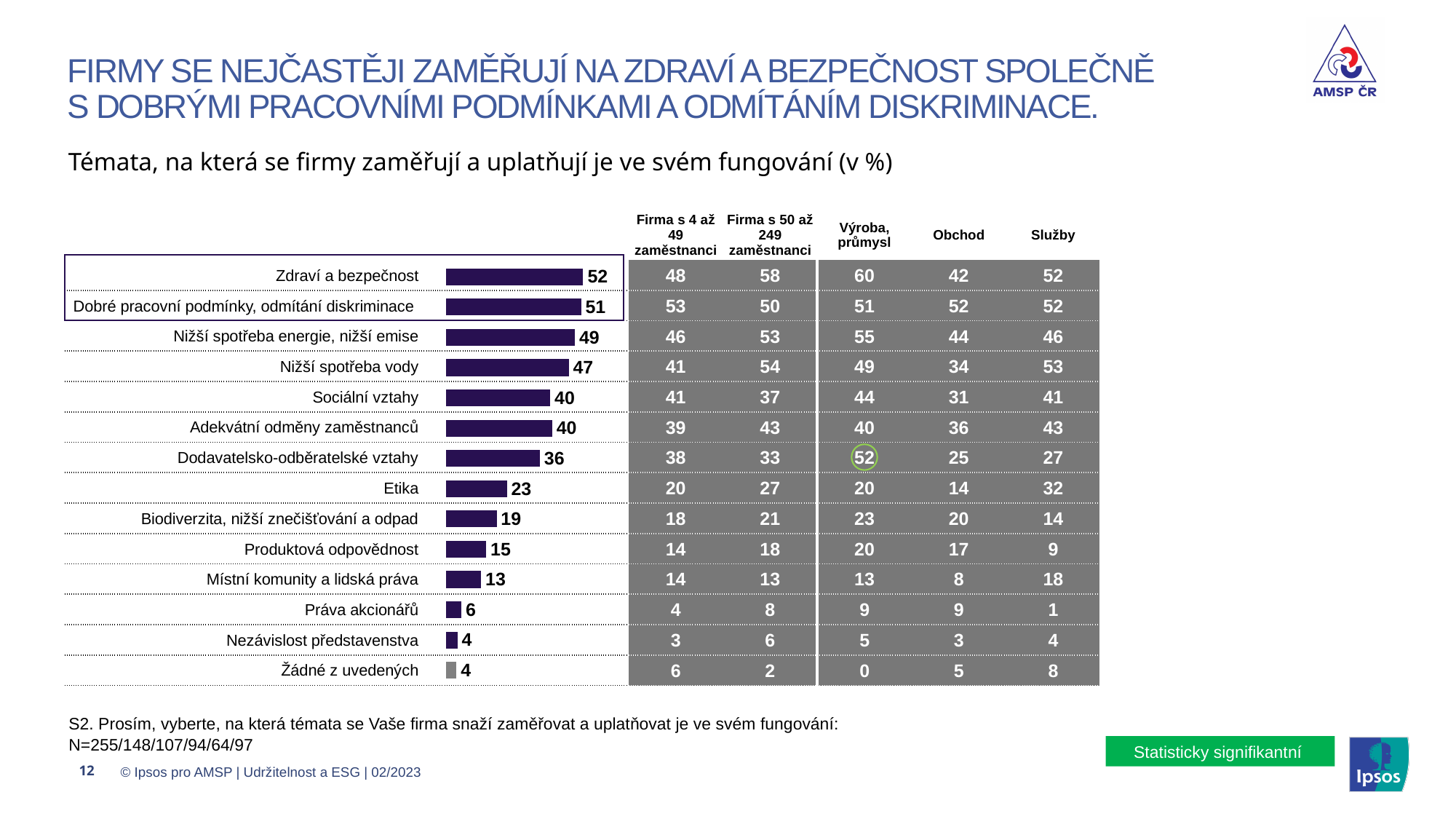
Which has a larger value in the bar chart, Nižší spotřeba vody or Sociální vztahy? Nižší spotřeba vody How many categories are shown in the bar chart? 14 What kind of chart is shown on the slide? Bar chart What is the title of the chart on the slide? Témata, na která se firmy zaměřují a uplatňují je ve svém fungování (v %) What is the difference between the values for Nižší spotřeba energie, nižší emise and Etika in the bar chart? 26 What is the value for Dodavatelsko-odběratelské vztahy in the bar chart? 36 Which category has the highest value in the bar chart? Zdraví a bezpečnost Which has a larger value in the bar chart, Biodiverzita, nižší znečišťování a odpad or Produktová odpovědnost? Biodiverzita, nižší znečišťování a odpad What is the value for Práva akcionářů in the bar chart? 6 What is the value for Zdraví a bezpečnost in the bar chart? 52 What is the difference between the values for Zdraví a bezpečnost and Dodavatelsko-odběratelské vztahy in the bar chart? 16 What is the value for Etika in the bar chart? 23